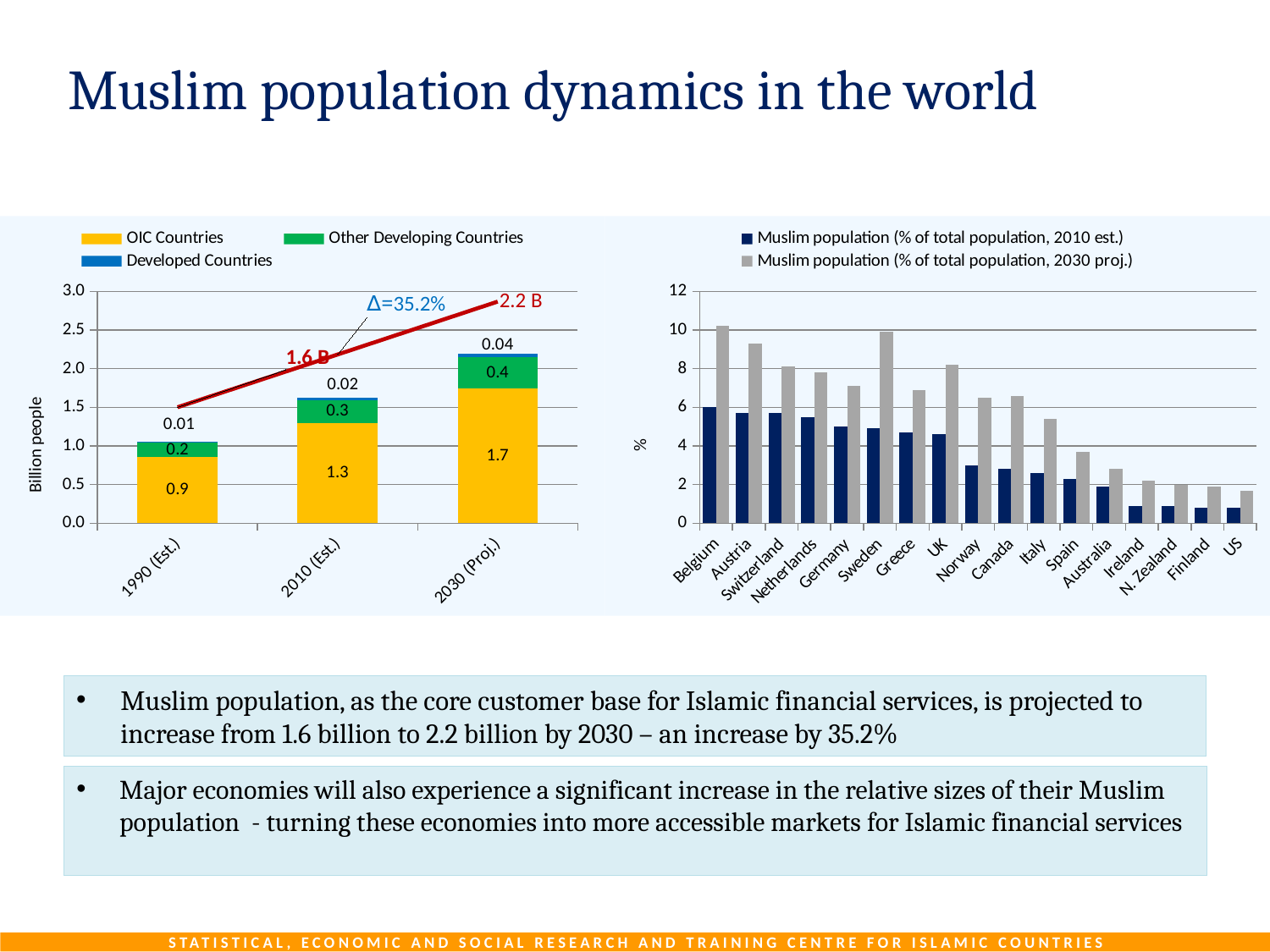
In the left chart (Billion people), what is the value for Developed Countries in 1990 (Est.)? 0.01 In the left chart (Billion people), by how much does the OIC Countries value increase from 1990 (Est.) to 2030 (Proj.)? 0.8 In the left chart (Billion people), how many series does the legend list? 3 In the right chart (Muslim population % of total population), is the 2010 est. value for the US greater or less than 2? less In the left chart (Billion people), what is the value for Other Developing Countries in 2010 (Est.)? 0.3 In the left chart (Billion people), do the OIC Countries values rise or fall from 1990 to 2030? rise In the right chart (Muslim population % of total population), how many countries are shown on the x axis? 17 In the left chart (Billion people), what is the total Muslim population shown for 2010 (Est.)? 1.6 B What percentage increase is annotated between 1.6 B and 2.2 B in the left chart? 35.2% In the left chart (Billion people), what is the value for OIC Countries in 2030 (Proj.)? 1.7 What kind of chart is the right chart (Muslim population % of total population)? bar chart